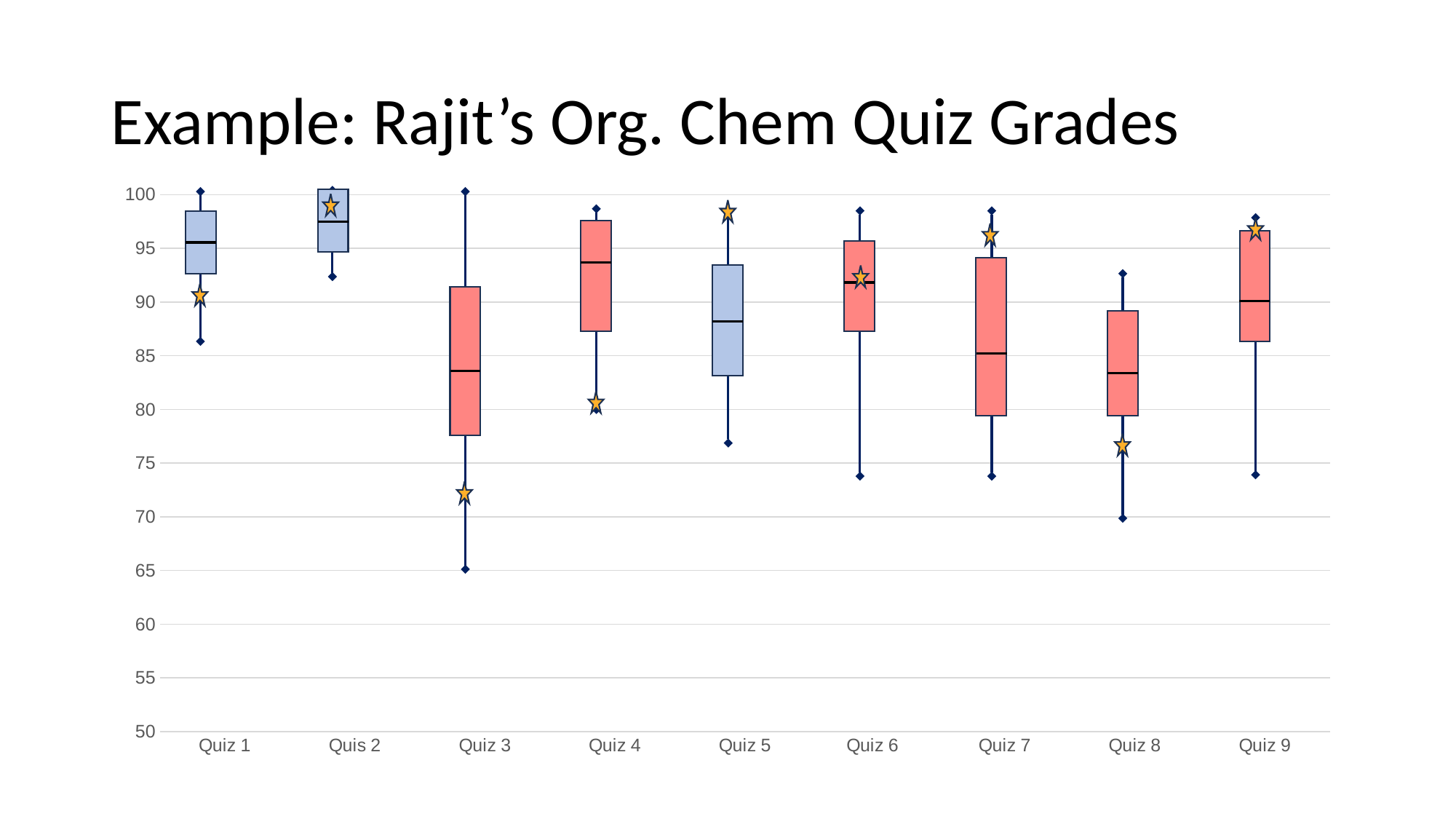
What kind of chart is shown on the slide? Box plot (box-and-whisker chart) How many of the boxes are coloured blue rather than red? 3 Which quiz has the lowest star marker? Quiz 3 Is the bottom whisker for Quiz 8 greater or less than 75? less Is the median line for Quiz 5 greater or less than 90? less Which quiz has the highest median line? Quis 2 Is the star marker for Quiz 3 greater or less than 75? less Which quiz has the lowest bottom whisker (minimum value)? Quiz 3 What is the title of the slide? Example: Rajit's Org. Chem Quiz Grades Which has the higher star marker, Quiz 1 or Quiz 4? Quiz 1 How many quizzes are shown along the x axis? 9